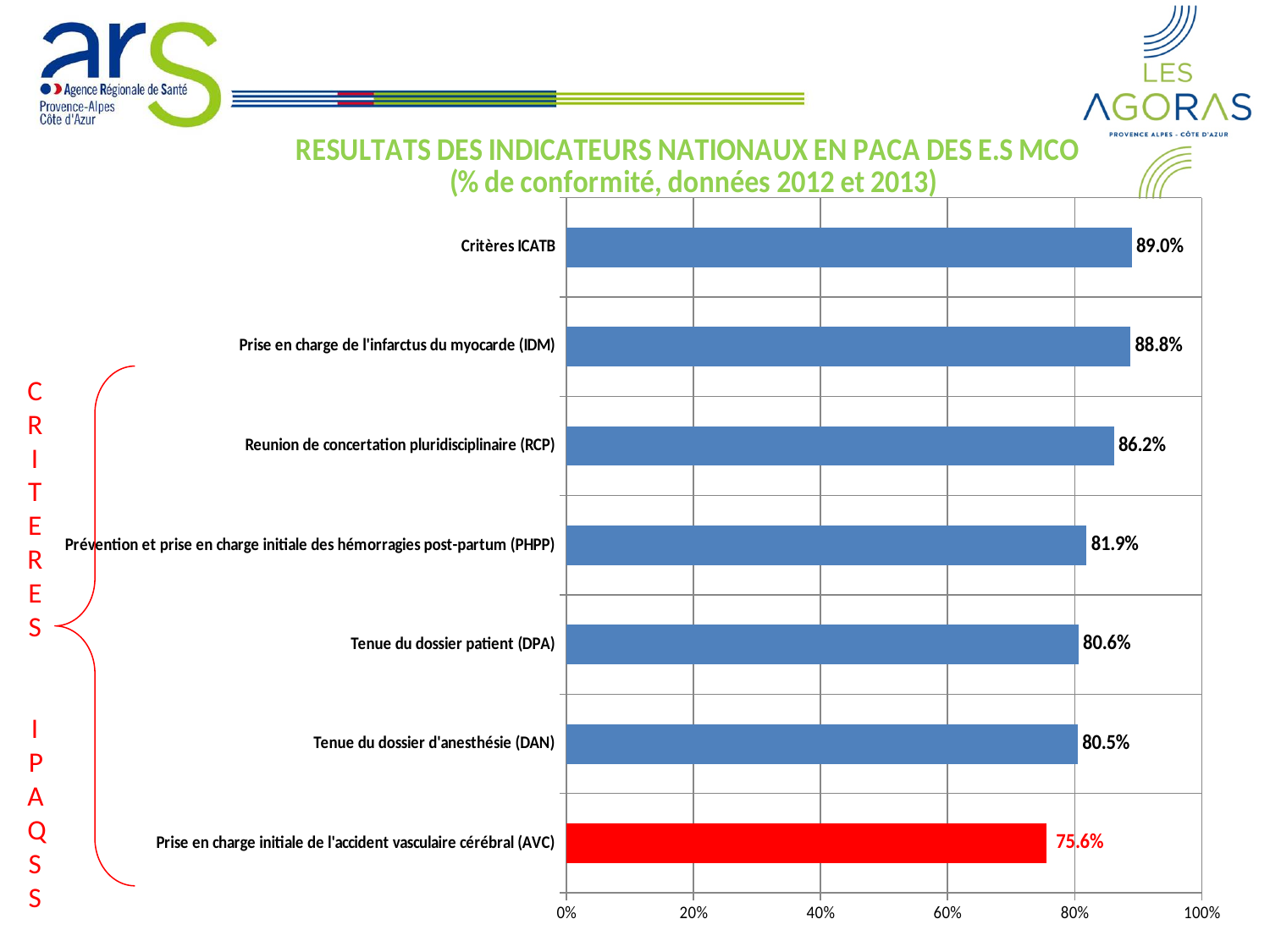
What is the value for Prise en charge initiale de l'accident vasculaire cérébral (AVC)? 75.6% What kind of chart is shown on the slide? bar chart Which bar is coloured red instead of blue? Prise en charge initiale de l'accident vasculaire cérébral (AVC) Which is larger: the value for Reunion de concertation pluridisciplinaire (RCP) or the value for Prévention et prise en charge initiale des hémorragies post-partum (PHPP)? Reunion de concertation pluridisciplinaire (RCP) How many categories are shown in the chart? 7 What is the value for Critères ICATB? 89.0% Which category has the lowest value? Prise en charge initiale de l'accident vasculaire cérébral (AVC) Which category has the highest value? Critères ICATB Is the value for Tenue du dossier d'anesthésie (DAN) greater or less than 80%? greater What is the difference between the values for Critères ICATB and Prise en charge initiale de l'accident vasculaire cérébral (AVC)? 13.4% What is the value for Tenue du dossier patient (DPA)? 80.6% What is the difference between the values for Prise en charge de l'infarctus du myocarde (IDM) and Tenue du dossier patient (DPA)? 8.2%